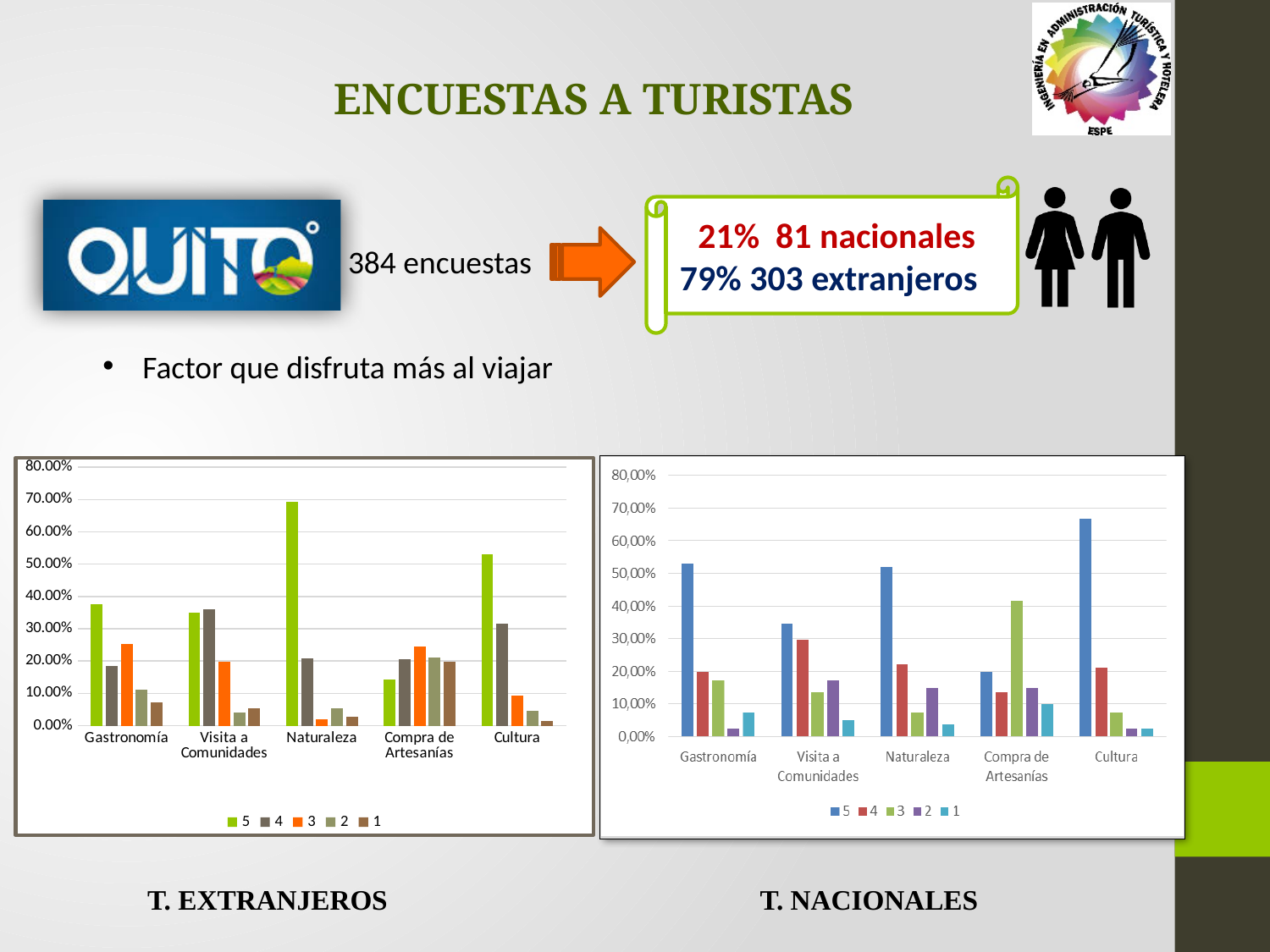
In the T. EXTRANJEROS chart, which category has the lowest value for series 5? Compra de Artesanías What is the label printed below the chart on the right? T. NACIONALES In the T. NACIONALES chart, is the value of series 5 for Compra de Artesanías greater or less than 30,00%? less In the T. NACIONALES chart, which category has the highest value for series 5? Cultura In the T. EXTRANJEROS chart, is the value of series 5 for Naturaleza greater or less than 60.00%? greater In the T. EXTRANJEROS chart, which category has the highest value for series 5? Naturaleza How many categories are shown on the x axis of the T. EXTRANJEROS chart? 5 What kind of chart is the T. EXTRANJEROS chart on the left? bar chart In the T. NACIONALES chart, is the value of series 5 for Cultura greater or less than 60,00%? greater How many series does the legend of the T. NACIONALES chart list? 5 In the T. EXTRANJEROS chart, which is larger for Cultura: series 5 or series 4? series 5 In the T. NACIONALES chart, which category has the highest value for series 3? Compra de Artesanías